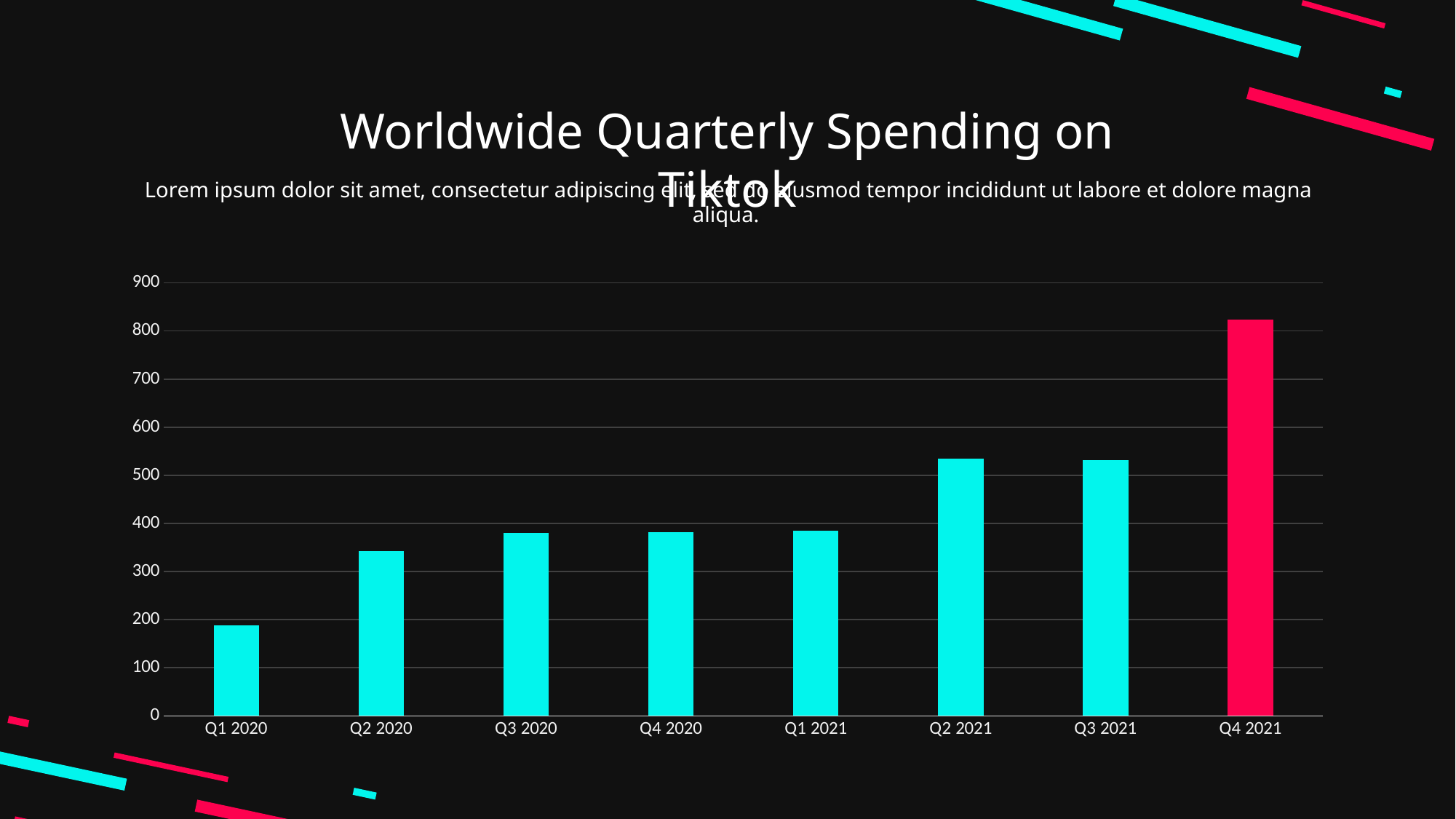
What is the title of the chart on the slide? Worldwide Quarterly Spending on Tiktok Is the value for Q1 2020 greater or less than 200? less Which quarter has the highest value? Q4 2021 What kind of chart is shown on the slide? bar chart Which quarter has the lowest value? Q1 2020 Do the values generally rise or fall from Q1 2020 to Q4 2021? rise Which bar is shown in a different colour (pink) from the others? Q4 2021 Is the value for Q2 2020 greater or less than 400? less Is the value for Q2 2021 greater or less than 500? greater Which is larger, the value for Q1 2021 or the value for Q2 2021? Q2 2021 How many quarters are plotted on the x axis? 8